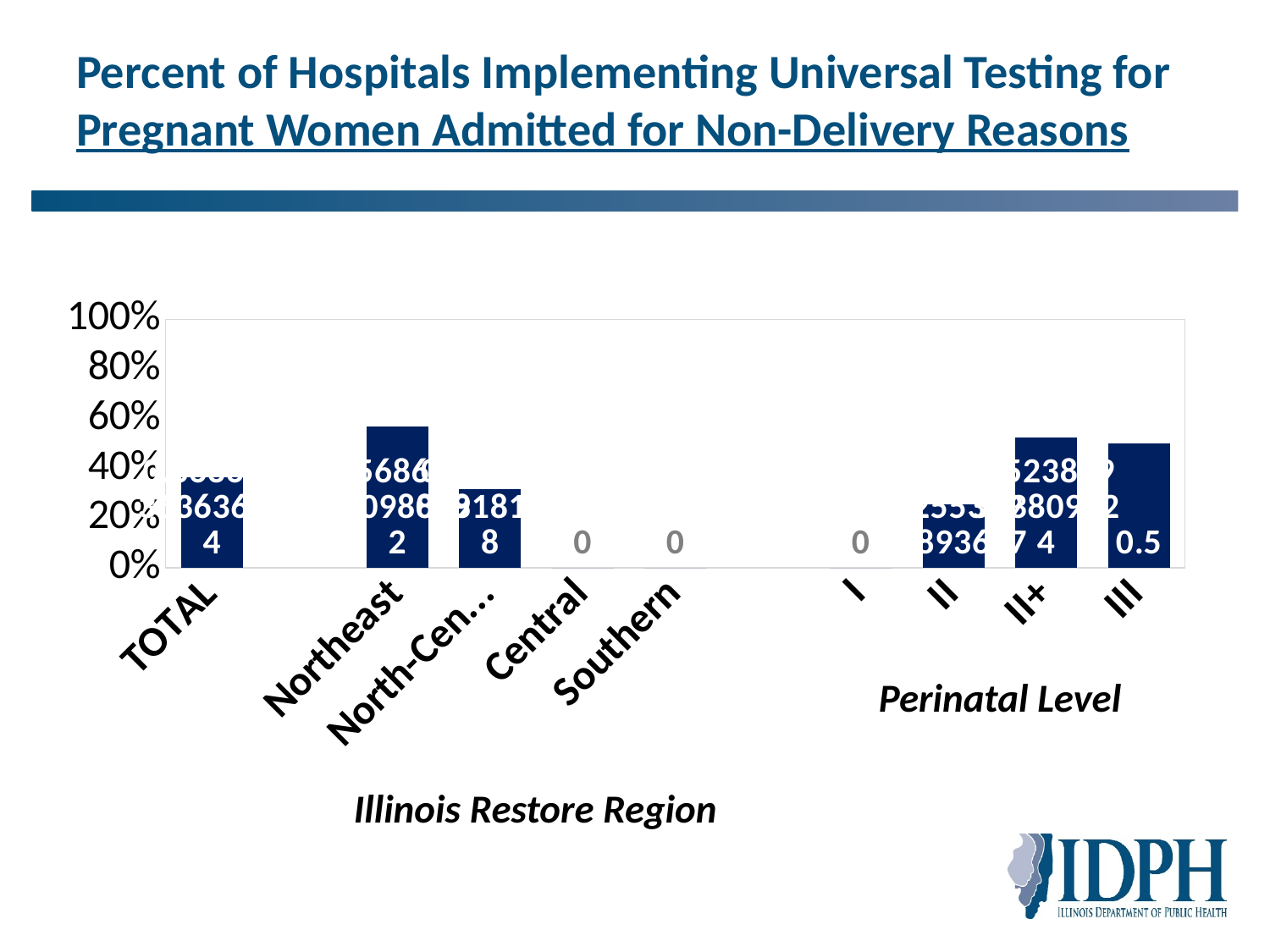
Is the value for Northeast greater or less than 40%? greater What is the value shown for Southern? 0 What kind of chart is shown on the slide? bar chart Which category has the highest bar? Northeast Is the value for TOTAL greater or less than 20%? greater Which is larger, the value for Northeast or the value for North-Central? Northeast What is the data label shown for perinatal level III? 0.5 What are the two group labels shown beneath the x axis? Illinois Restore Region and Perinatal Level Is the value for perinatal level II greater or less than 40%? less What is the value shown for perinatal level I? 0 What is the value shown for Central? 0 How many labelled categories are on the x axis? 9